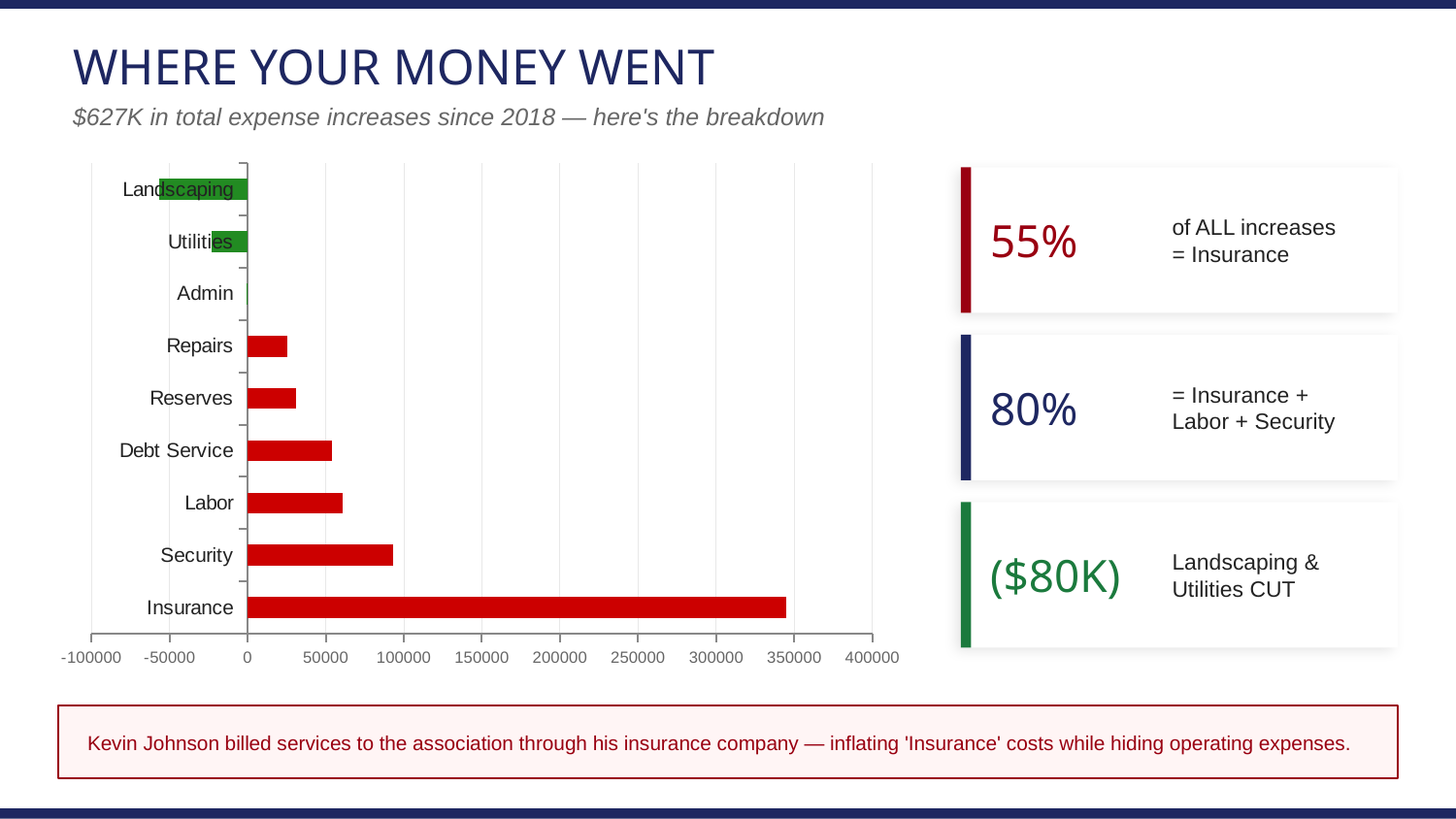
How many bars in the chart are coloured green? 3 Is the value for Insurance greater or less than 300000? greater Is the value for Landscaping greater or less than 0? less How many categories are plotted in the bar chart? 9 Which category has the lowest value in the bar chart? Landscaping Is the value for Security greater or less than 100000? less What kind of chart is shown on the slide? bar chart Which has the larger value, Security or Labor? Security What is the title of the slide containing the chart? WHERE YOUR MONEY WENT Which has the larger value, Insurance or Security? Insurance Which category has the highest value in the bar chart? Insurance